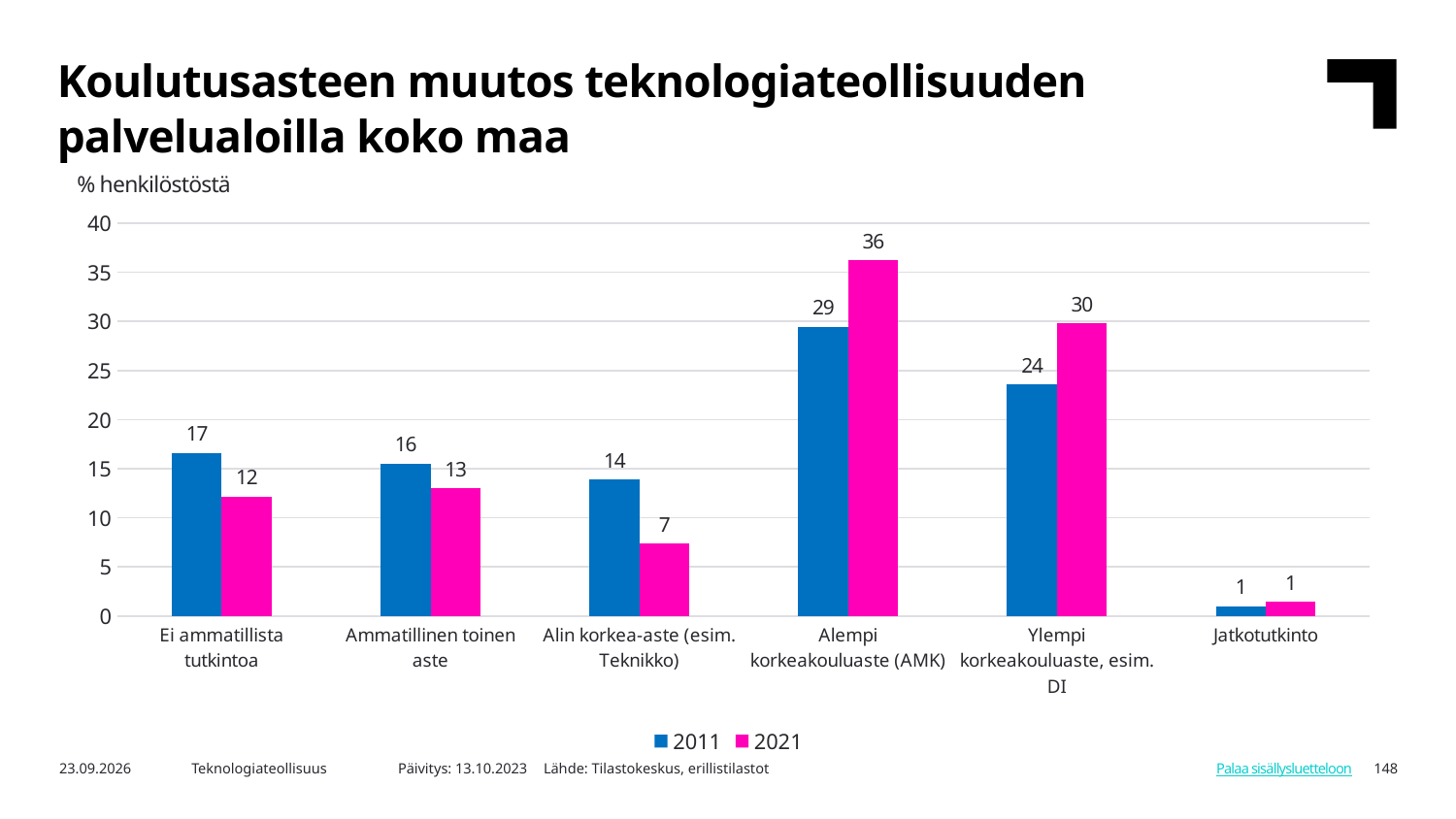
Which category has the lowest 2011 value? Jatkotutkinto What type of chart is shown on the slide? bar chart How many series does the legend list? 2 What is the 2021 value for Alin korkea-aste (esim. Teknikko)? 7 What is the difference between the 2021 and 2011 values for Alempi korkeakouluaste (AMK)? 7 What is the 2011 value for Ylempi korkeakouluaste, esim. DI? 24 Which colour represents the 2021 series in the legend? magenta (pink) What is the 2021 value for Alempi korkeakouluaste (AMK)? 36 For Ei ammatillista tutkintoa, which is larger: the 2011 value or the 2021 value? 2011 Is the 2021 value for Ylempi korkeakouluaste, esim. DI greater or less than 25? greater Which category has the highest 2021 value? Alempi korkeakouluaste (AMK) How many education-level categories are shown on the x axis? 6